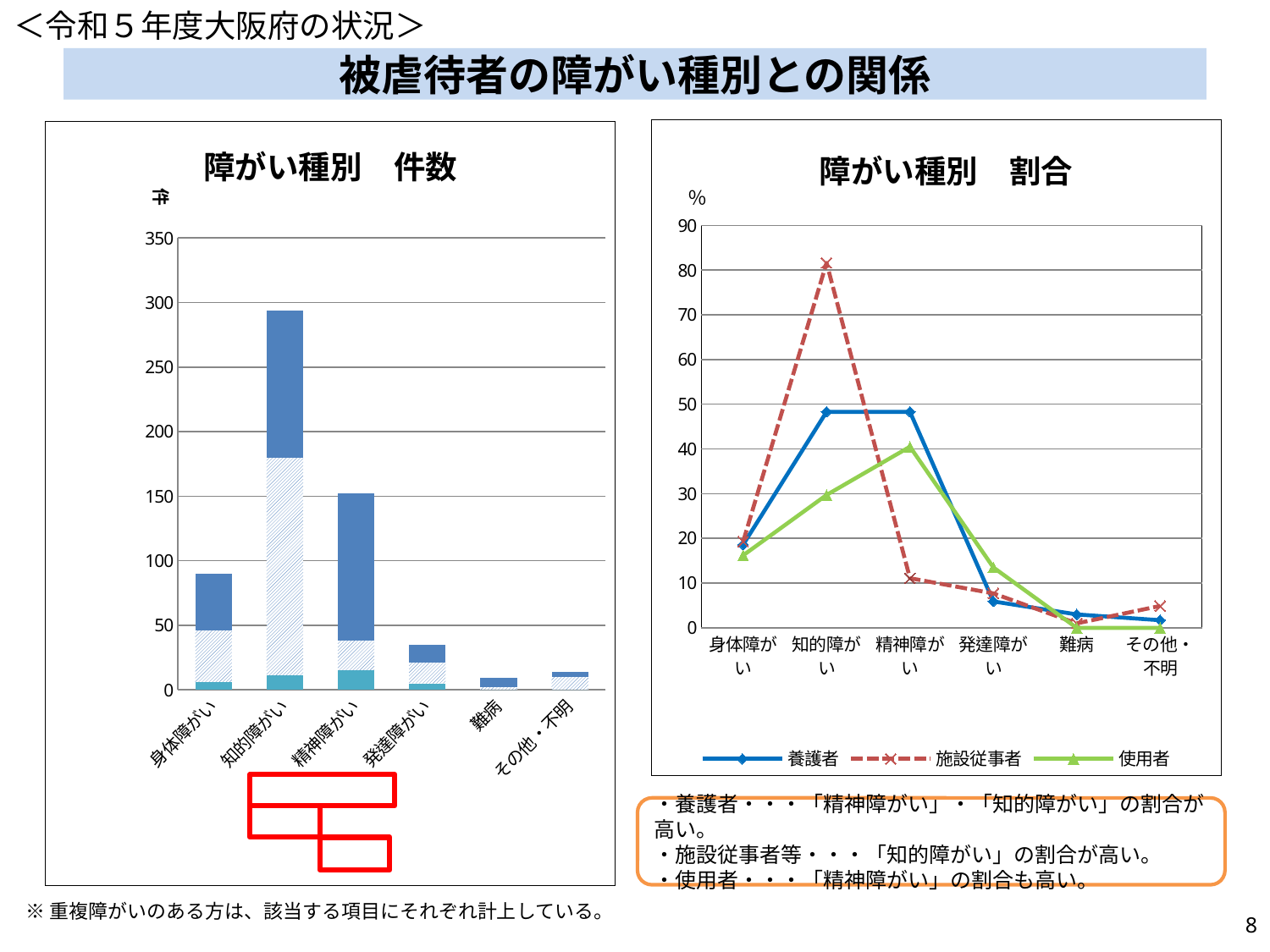
In the left chart 障がい種別 件数, is the total bar for 知的障がい greater or less than 250? greater In the left chart 障がい種別 件数, is the total bar for 精神障がい greater or less than 100? greater In the right chart 障がい種別 割合, how many series does the legend list? 3 What kind of chart is the left chart titled 障がい種別 件数? bar chart In the left chart 障がい種別 件数, is the total bar for 身体障がい greater or less than 100? less In the right chart 障がい種別 割合, which category has the highest value for 施設従事者? 知的障がい In the left chart 障がい種別 件数, which category has the tallest bar? 知的障がい In the right chart 障がい種別 割合, which category has the highest value for 使用者? 精神障がい What kind of chart is the right chart titled 障がい種別 割合? line chart In the right chart 障がい種別 割合, at 知的障がい, which series has the larger value: 養護者 or 施設従事者? 施設従事者 In the left chart 障がい種別 件数, how many categories are shown on the x axis? 6